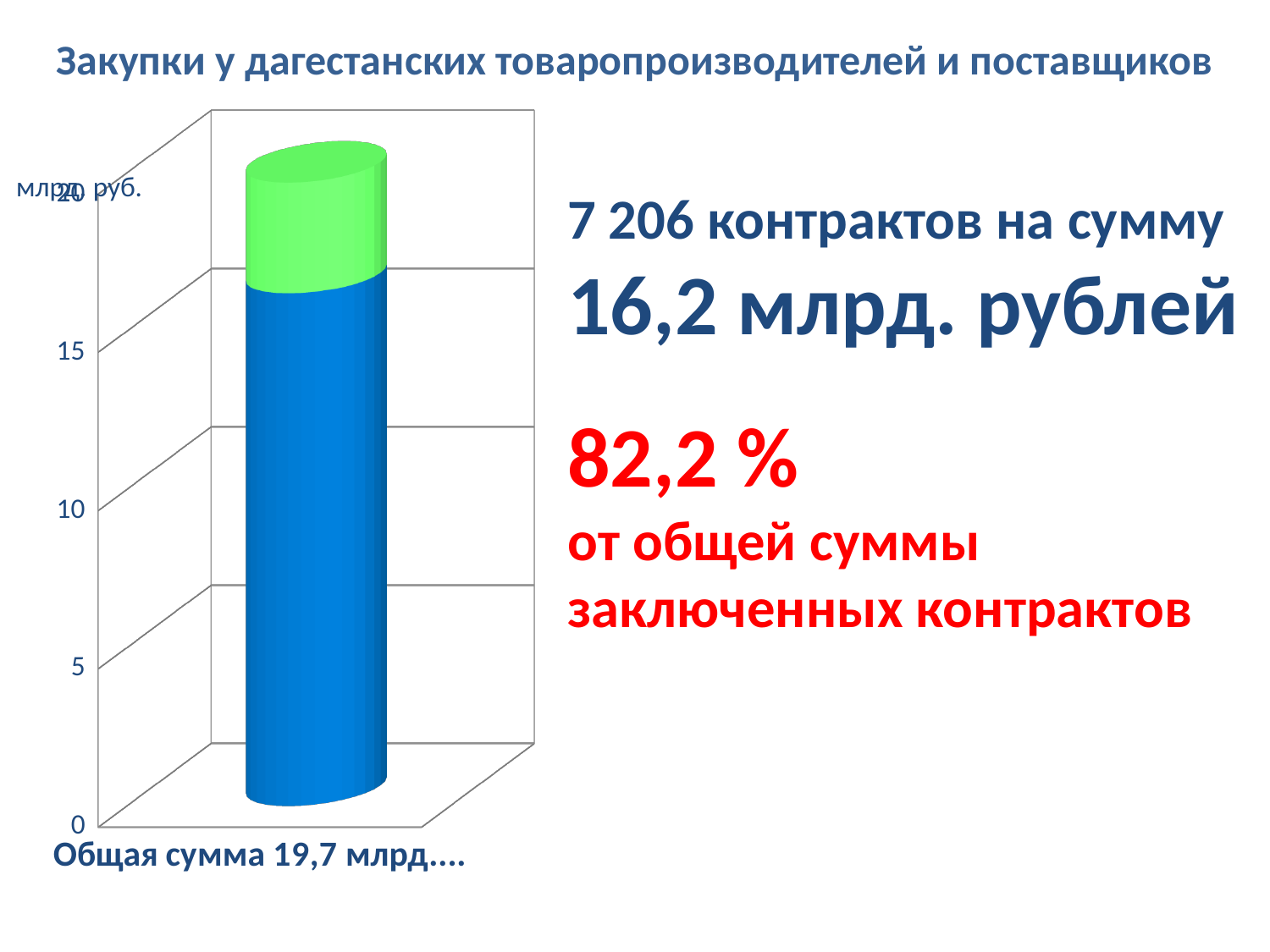
Is the value of the blue (bottom) segment of the bar greater or less than 15? greater How many categories (bars) does the chart show? 1 Which segment of the stacked bar is larger, the blue one or the green one? the blue one Is the value of the green (top) segment of the bar greater or less than 5? less What is the highest tick value shown on the vertical axis of the chart? 20 Is the total height of the stacked bar greater or less than 15? greater What unit label is shown next to the vertical axis of the chart? млрд. руб. What kind of chart is shown on the slide? bar chart How many stacked segments make up the bar in the chart? 2